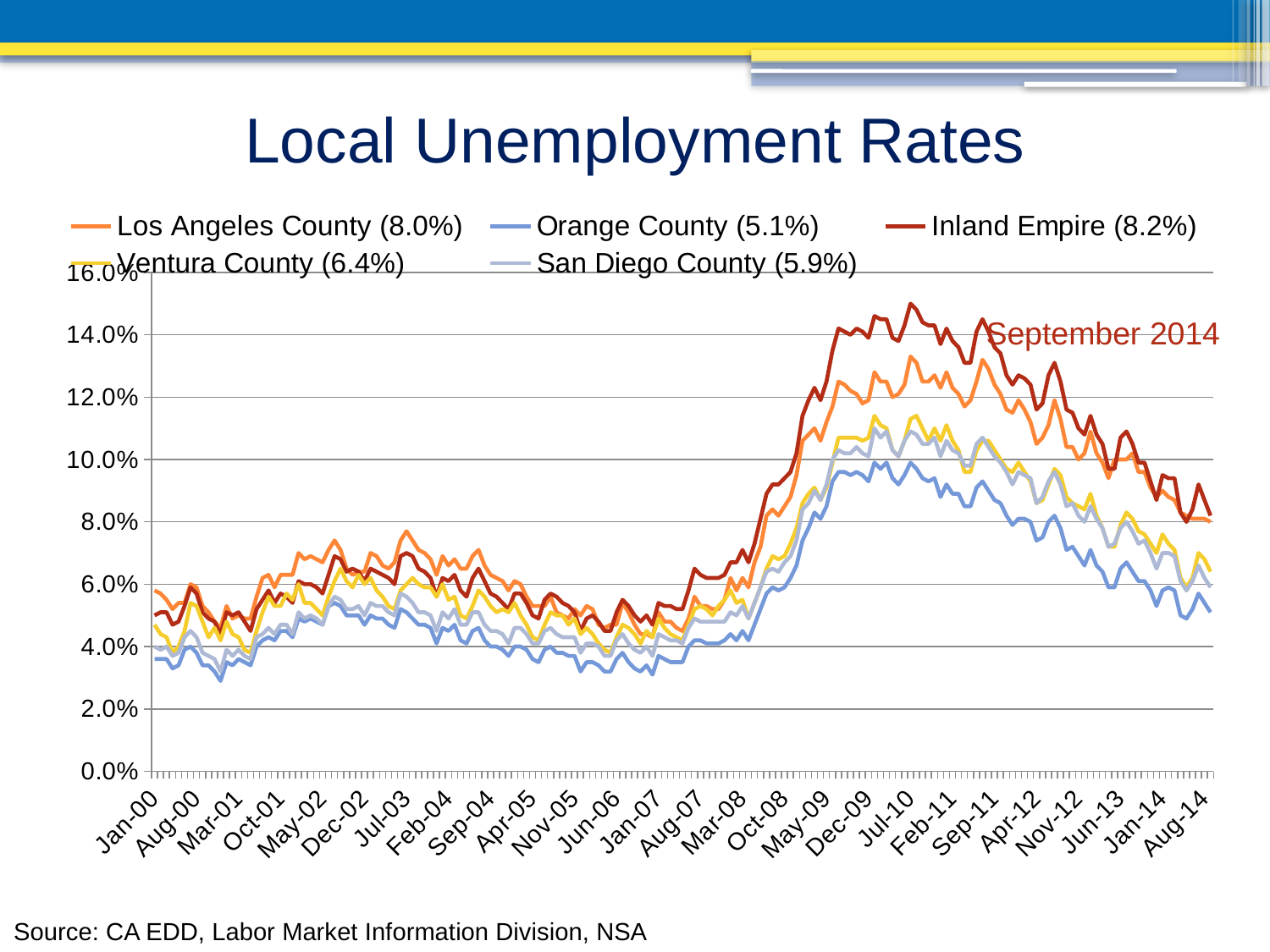
Which has the higher September 2014 unemployment rate, Ventura County or San Diego County? Ventura County How many series does the legend list? 5 Which region has the highest September 2014 unemployment rate according to the legend? Inland Empire Is the peak value of the Inland Empire line around 2010 greater or less than 14.0%? greater Which region has the lowest September 2014 unemployment rate according to the legend? Orange County What source is cited at the bottom of the slide? CA EDD, Labor Market Information Division, NSA What is the September 2014 unemployment rate for the Inland Empire shown in the legend? 8.2% What kind of chart is shown on the slide? line chart What is the September 2014 unemployment rate for Orange County shown in the legend? 5.1% What is the difference between the September 2014 rates for the Inland Empire and Orange County? 3.1 percentage points From around Jul-10 to Aug-14, do the unemployment rates generally rise or fall? fall What is the September 2014 unemployment rate for Los Angeles County shown in the legend? 8.0%